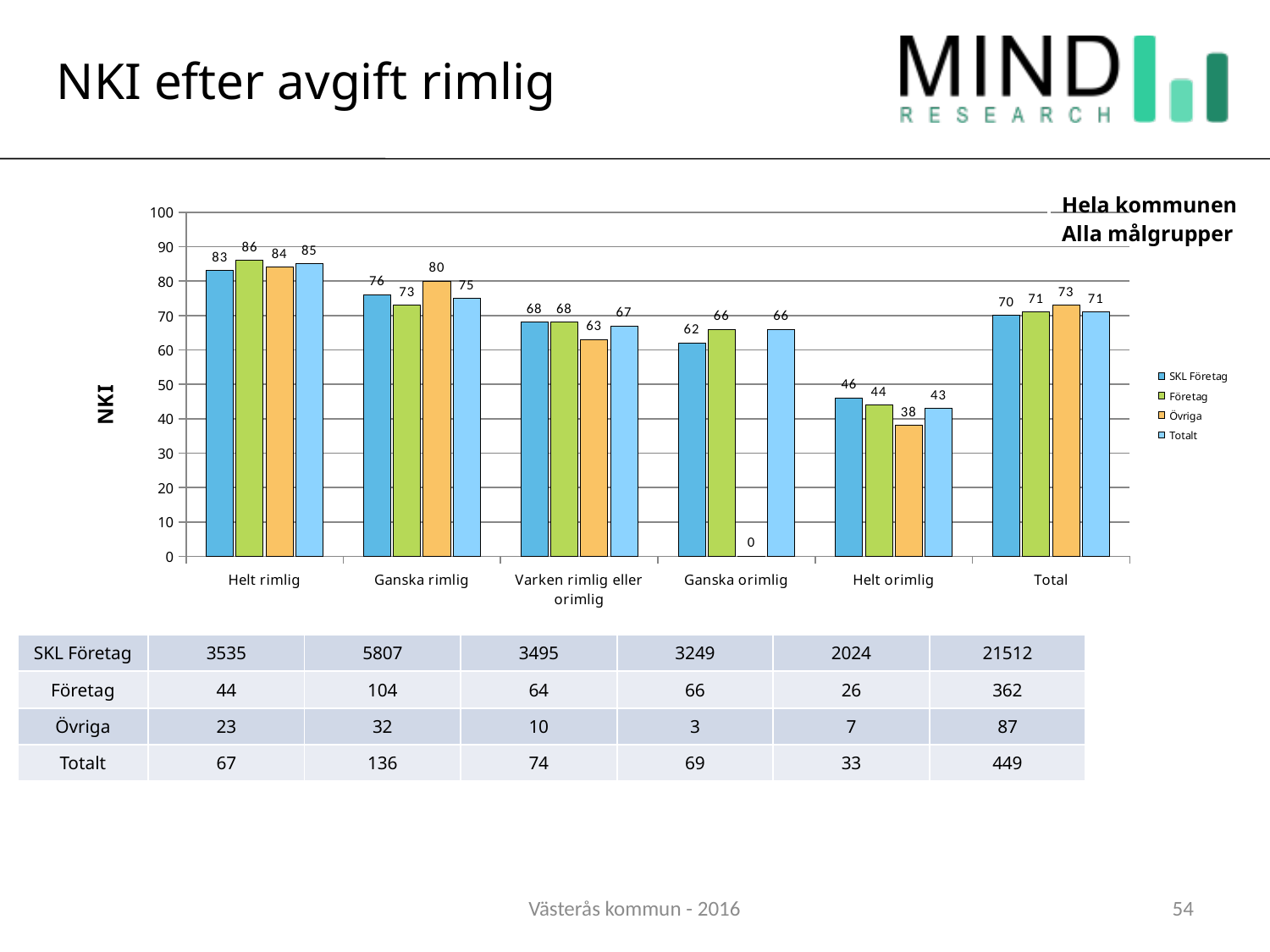
Which is larger: the Övriga value for Varken rimlig eller orimlig or the Övriga value for Helt orimlig? Varken rimlig eller orimlig Which category has the highest NKI value for Företag? Helt rimlig What is the NKI value for Övriga in the Ganska orimlig category? 0 What kind of chart is shown on the slide? bar chart What is the label on the y axis of the chart? NKI How many series does the legend list? 4 What is the difference between the Totalt values for Helt rimlig and Helt orimlig? 42 What is the NKI value for Övriga in the Ganska rimlig category? 80 How many categories are shown on the x axis of the chart? 6 What is the NKI value for Totalt in the Helt orimlig category? 43 What is the NKI value for SKL Företag in the Helt rimlig category? 83 Which category has the lowest NKI value for SKL Företag? Helt orimlig